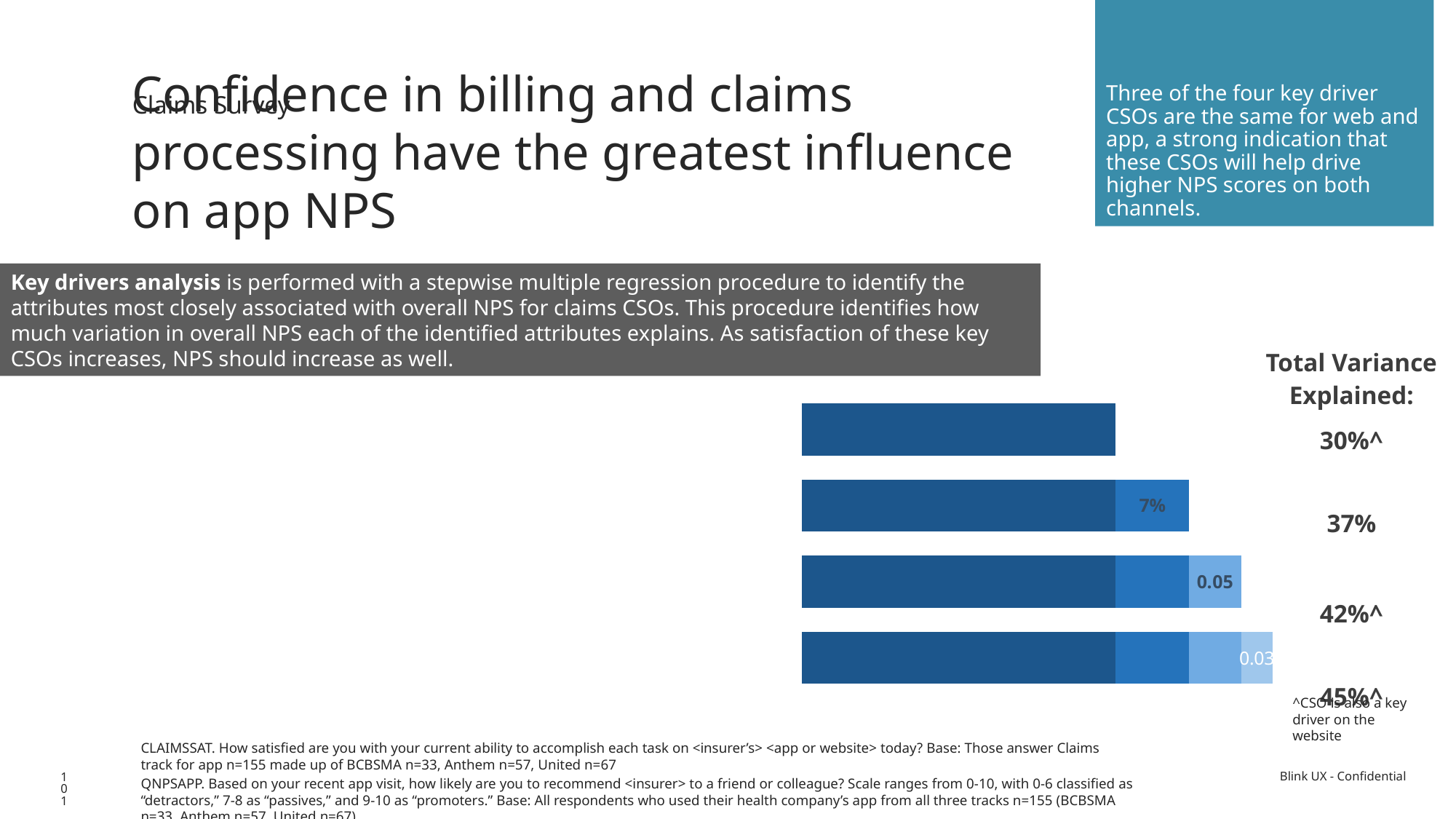
How many stacked segments make up the bottom bar? 4 What data label is printed on the lightest segment of the bottom bar? 0.03 Do the bars get longer or shorter moving from the top bar to the bottom bar? longer Which bar in the chart is the longest overall? the bottom bar What data label is printed on the lightest segment of the third bar from the top? 0.05 What type of chart is shown on the slide? bar chart Which bar in the chart is the shortest overall? the top bar How many bars does the chart contain? 4 What data label is printed on the lighter blue segment of the second bar from the top? 7% What Total Variance Explained value is shown next to the top bar? 30%^ What Total Variance Explained value is shown next to the bottom bar? 45%^ What is the difference between the Total Variance Explained values for the bottom bar (45%) and the top bar (30%)? 15%